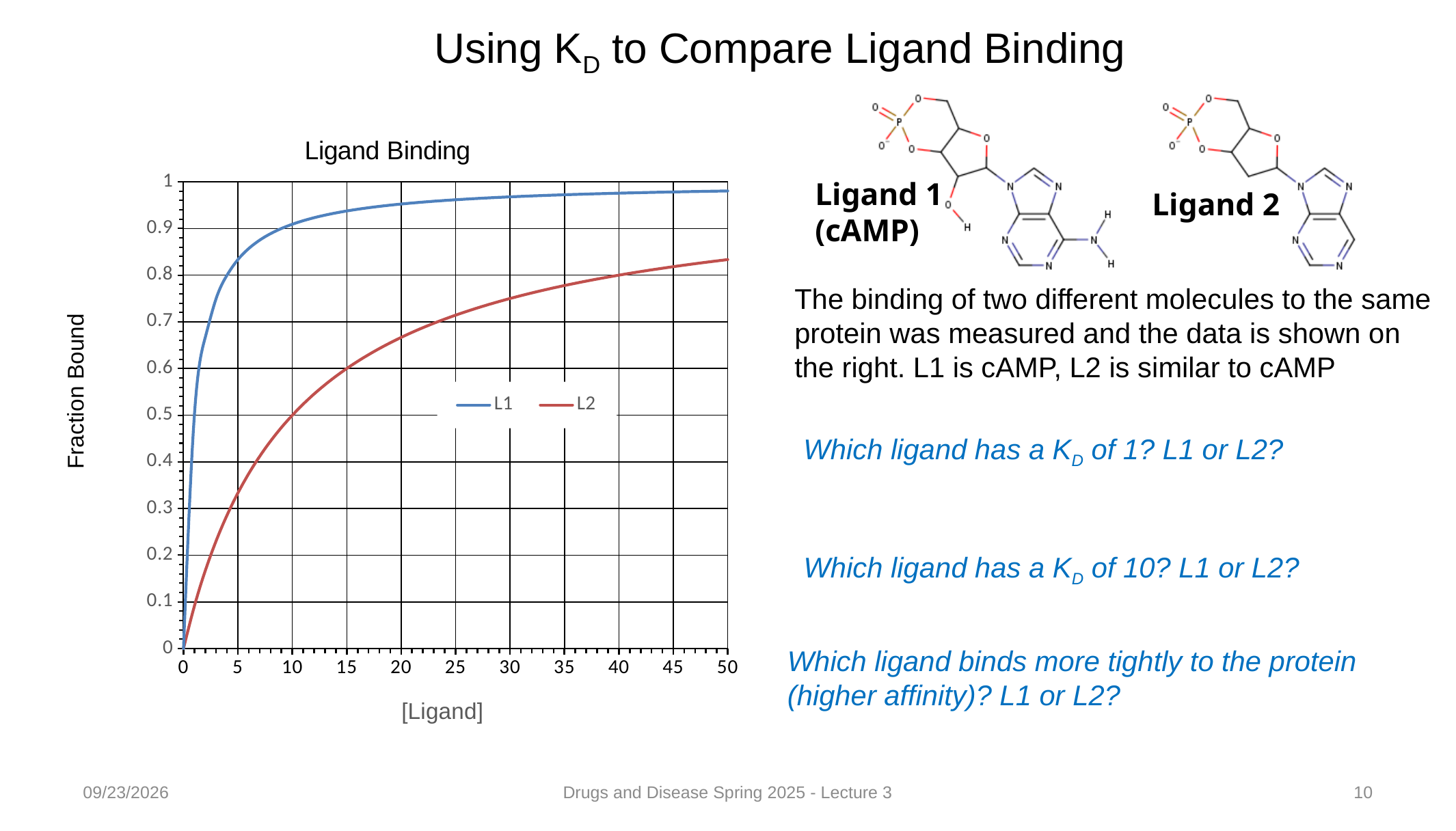
What is the title of the chart? Ligand Binding Is the Fraction Bound for L2 at [Ligand] = 20 greater or less than 0.6? greater What is the label of the chart's vertical axis? Fraction Bound How many series does the chart's legend list? 2 Is the Fraction Bound for L1 at [Ligand] = 20 greater or less than 0.9? greater Do the values for L2 rise or fall as [Ligand] increases? rise Is the Fraction Bound for L2 at [Ligand] = 50 greater or less than 0.9? less What kind of chart is shown on the slide? line chart At [Ligand] = 20, which series has the higher Fraction Bound, L1 or L2? L1 Do the values for L1 rise or fall as [Ligand] increases? rise